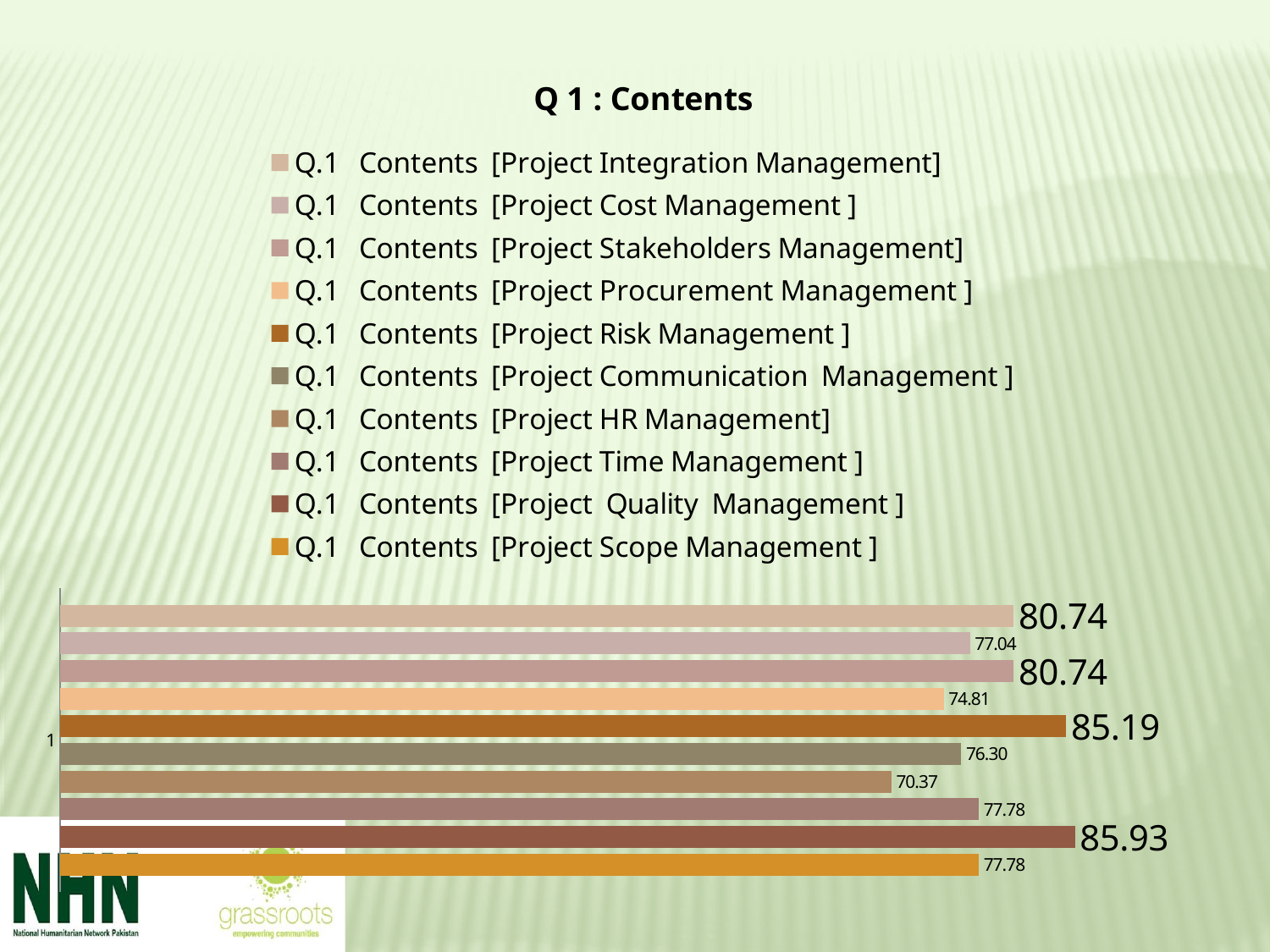
What is the value for Project Communication Management? 76.30 What is the value for Project HR Management? 70.37 What is the title of the slide containing the chart? Q 1 : Contents What is the value for Project Quality Management? 85.93 What type of chart is shown on the slide? bar chart What is the value for Project Procurement Management? 74.81 Which series has the lowest value? Project HR Management Which series has the highest value? Project Quality Management What is the value for Project Risk Management? 85.19 What is the difference between the values for Project Quality Management and Project HR Management? 15.56 How many series does the legend list? 10 Which is larger, the value for Project Cost Management or the value for Project Time Management? Project Time Management